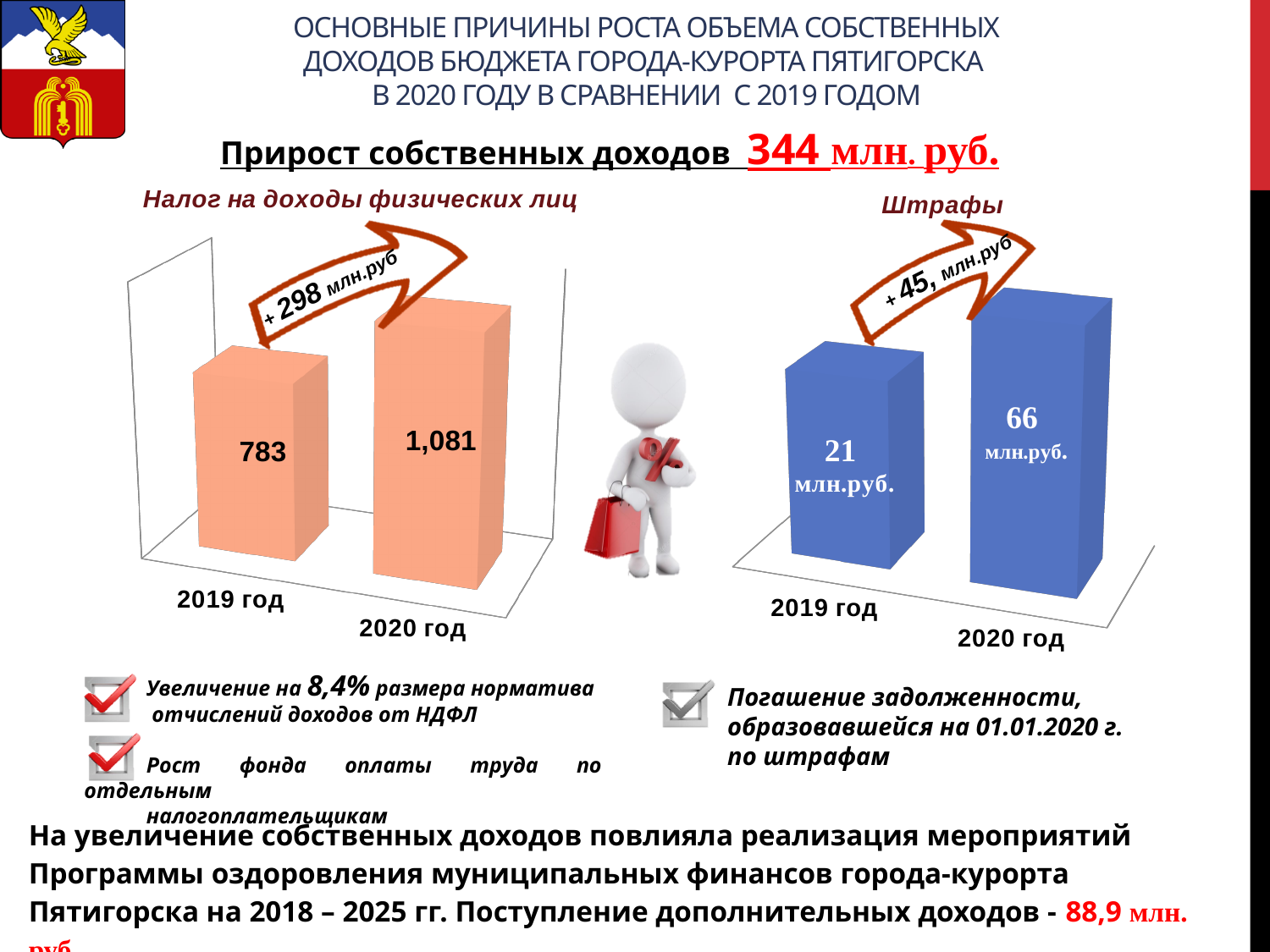
On the chart titled "Штрафы", which year has the lower value? 2019 год On the chart titled "Налог на доходы физических лиц", what is the value for 2019 год? 783 How many bars are shown on the chart titled "Налог на доходы физических лиц"? 2 On the chart titled "Налог на доходы физических лиц", which year has the higher value? 2020 год What kind of chart is the chart titled "Штрафы"? bar chart On the chart titled "Налог на доходы физических лиц", do the values rise or fall from 2019 год to 2020 год? rise On the chart titled "Налог на доходы физических лиц", what is the value for 2020 год? 1,081 On the chart titled "Штрафы", what is the value for 2019 год? 21 млн.руб. On the chart titled "Штрафы", what is the value for 2020 год? 66 млн.руб. On the chart titled "Штрафы", is the value for 2020 год larger or smaller than the value for 2019 год? larger On the chart titled "Штрафы", what is the difference between the 2020 год and 2019 год values? 45 млн.руб. On the chart titled "Налог на доходы физических лиц", what is the difference between the 2020 год and 2019 год values? 298